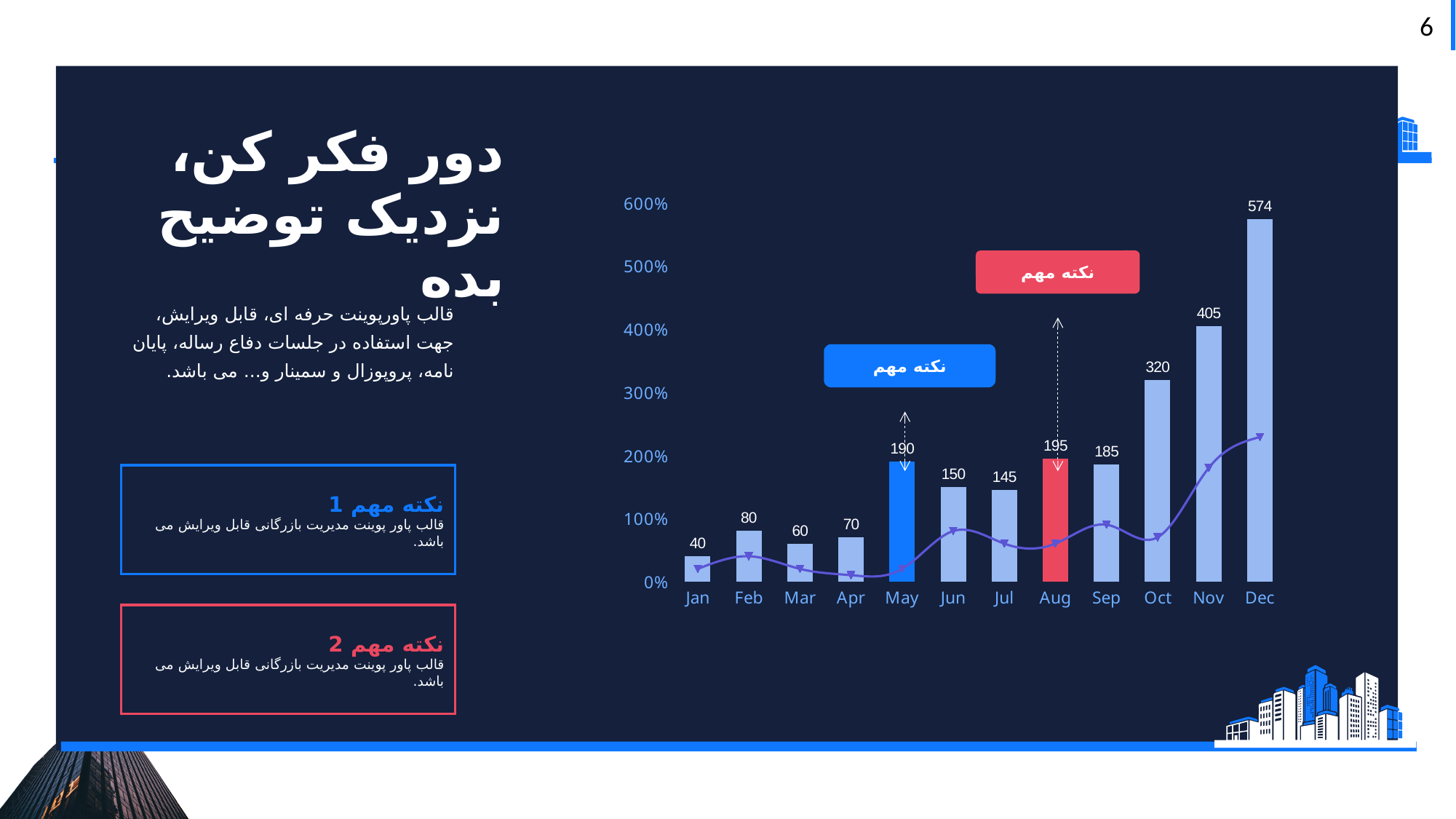
What is the value for Dec? 574 What is the value for May? 190 Which month has the highest bar? Dec Which is larger, the value for Jun or the value for Jul? Jun What kind of chart is shown on the slide? Bar chart with a line overlay Which month has the lowest bar? Jan Do the bar values generally rise or fall from Sep to Dec? Rise How many months are shown on the x axis? 12 What is the difference between the values for Nov and Oct? 85 Which is larger, the value for Feb or the value for Mar? Feb What is the value for Aug? 195 What is the difference between the values for Aug and May? 5